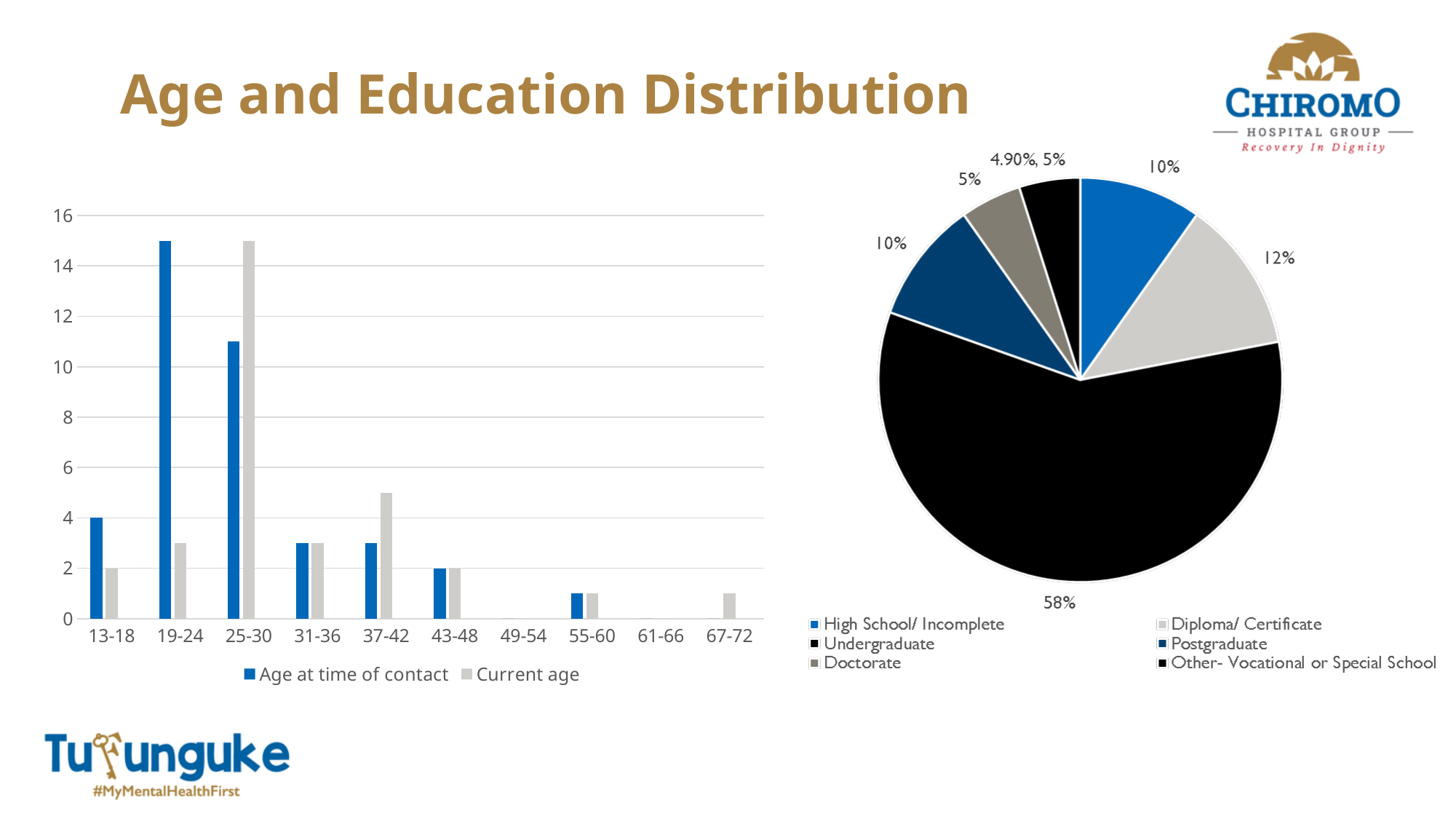
In the bar chart on the left, is the value of Age at time of contact for the 25-30 group greater or less than 10? greater In the bar chart on the left, what is the value of Age at time of contact for the 13-18 group? 4 In the bar chart on the left, which age group has the highest value for Age at time of contact? 19-24 In the bar chart on the left, how many age groups are shown on the x axis? 10 In the pie chart on the right, how many categories does the legend list? 6 In the bar chart on the left, how many series does the legend list? 2 In the bar chart on the left, what is the value of Current age for the 43-48 group? 2 What kind of chart is the chart on the right of the slide? pie chart In the bar chart on the left, which age group has the highest value for Current age? 25-30 What kind of chart is the chart on the left of the slide? bar chart In the bar chart on the left, for the 13-18 group, which is larger: Age at time of contact or Current age? Age at time of contact In the pie chart on the right, what share is Undergraduate? 58%